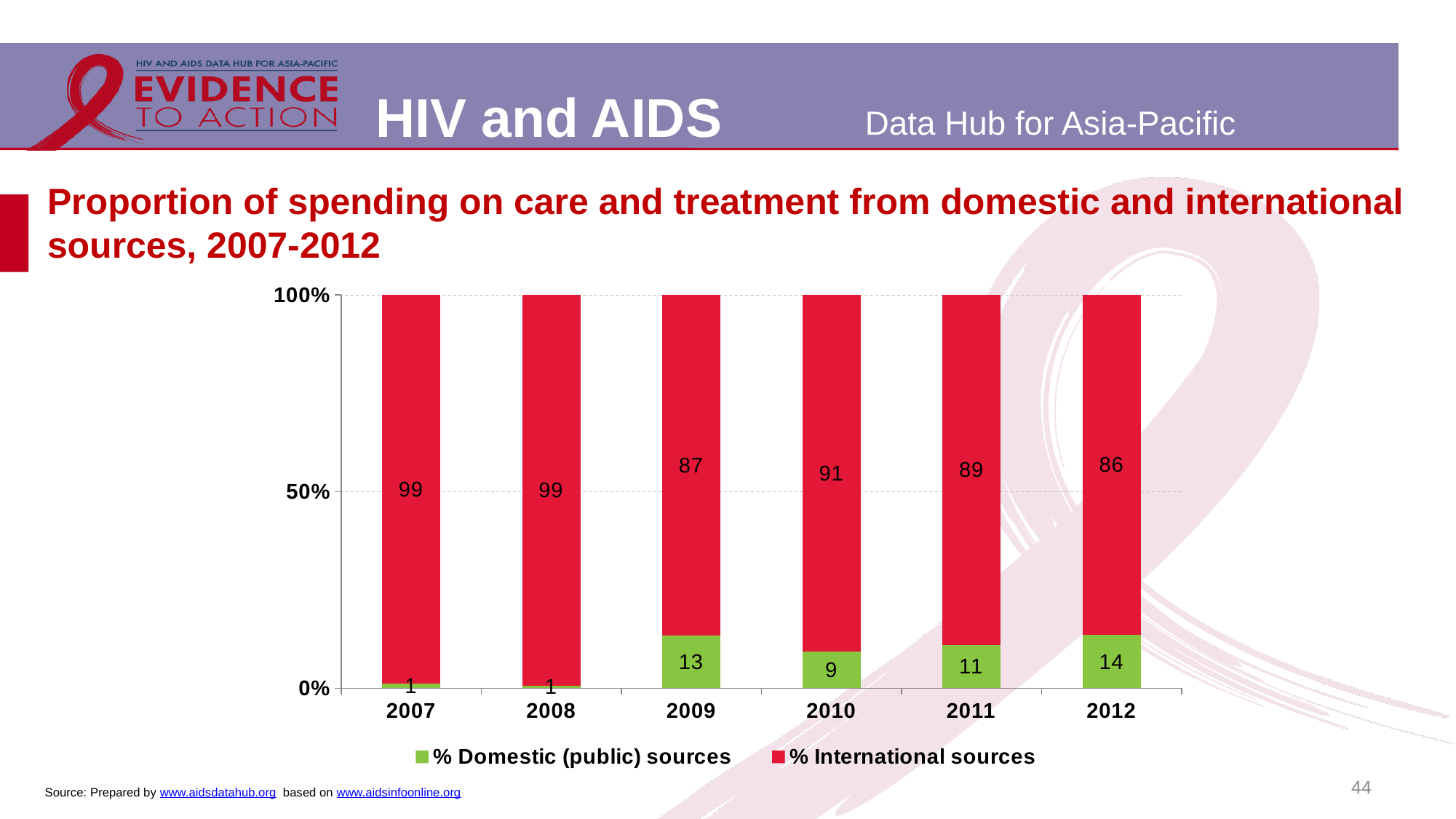
What is the difference between the % International sources values for 2007 and 2012? 13 What is the value for % International sources in 2009? 87 Is the value for % International sources in 2010 greater or less than 50%? greater How many series does the legend list? 2 What kind of chart is shown on the slide? Stacked bar chart What is the value for % Domestic (public) sources in 2010? 9 Which year has the highest value for % Domestic (public) sources? 2012 Which year has the lowest value for % International sources? 2012 How many years are shown on the x axis? 6 What is the value for % Domestic (public) sources in 2012? 14 Which is larger, the % Domestic (public) sources value for 2009 or for 2011? 2009 Which colour represents % International sources in the chart? Red